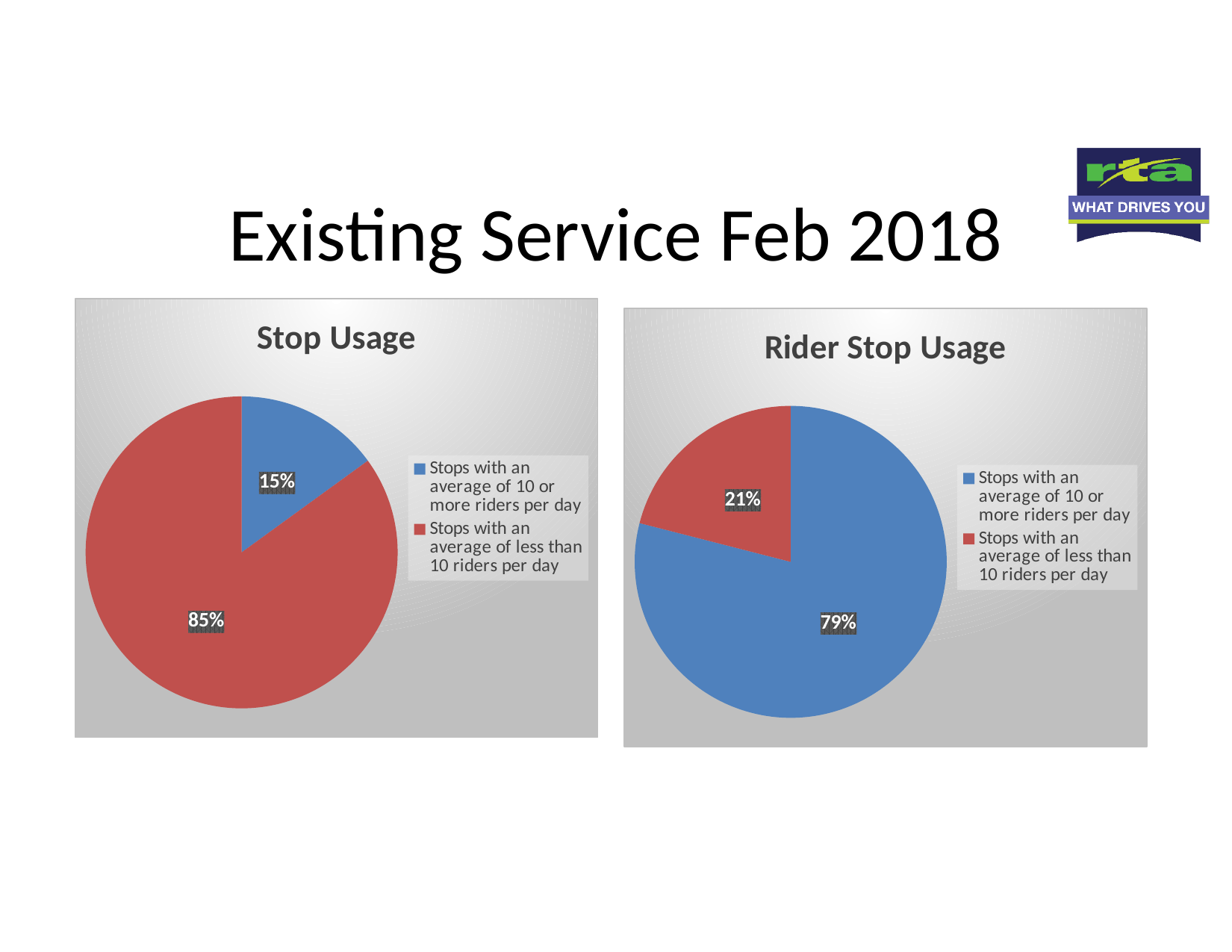
In the "Rider Stop Usage" chart, what is the difference in percentage points between the two slices? 58 In the "Stop Usage" chart, which category has the largest slice? Stops with an average of less than 10 riders per day How many slices does the "Rider Stop Usage" pie chart have? 2 What kind of chart is the "Stop Usage" chart? Pie chart In the "Stop Usage" chart, what colour is the slice for stops with an average of less than 10 riders per day? Red In the "Stop Usage" chart, what share of the pie is for stops with an average of less than 10 riders per day? 85% In the "Rider Stop Usage" chart, which is larger: the slice for stops with 10 or more riders per day or the slice for stops with less than 10 riders per day? Stops with an average of 10 or more riders per day In the "Rider Stop Usage" chart, what share of the pie is for stops with an average of 10 or more riders per day? 79% In the "Rider Stop Usage" chart, which category has the smallest slice? Stops with an average of less than 10 riders per day In the "Stop Usage" chart, what share of the pie is for stops with an average of 10 or more riders per day? 15% In the "Stop Usage" chart, what is the difference in percentage points between the two slices? 70